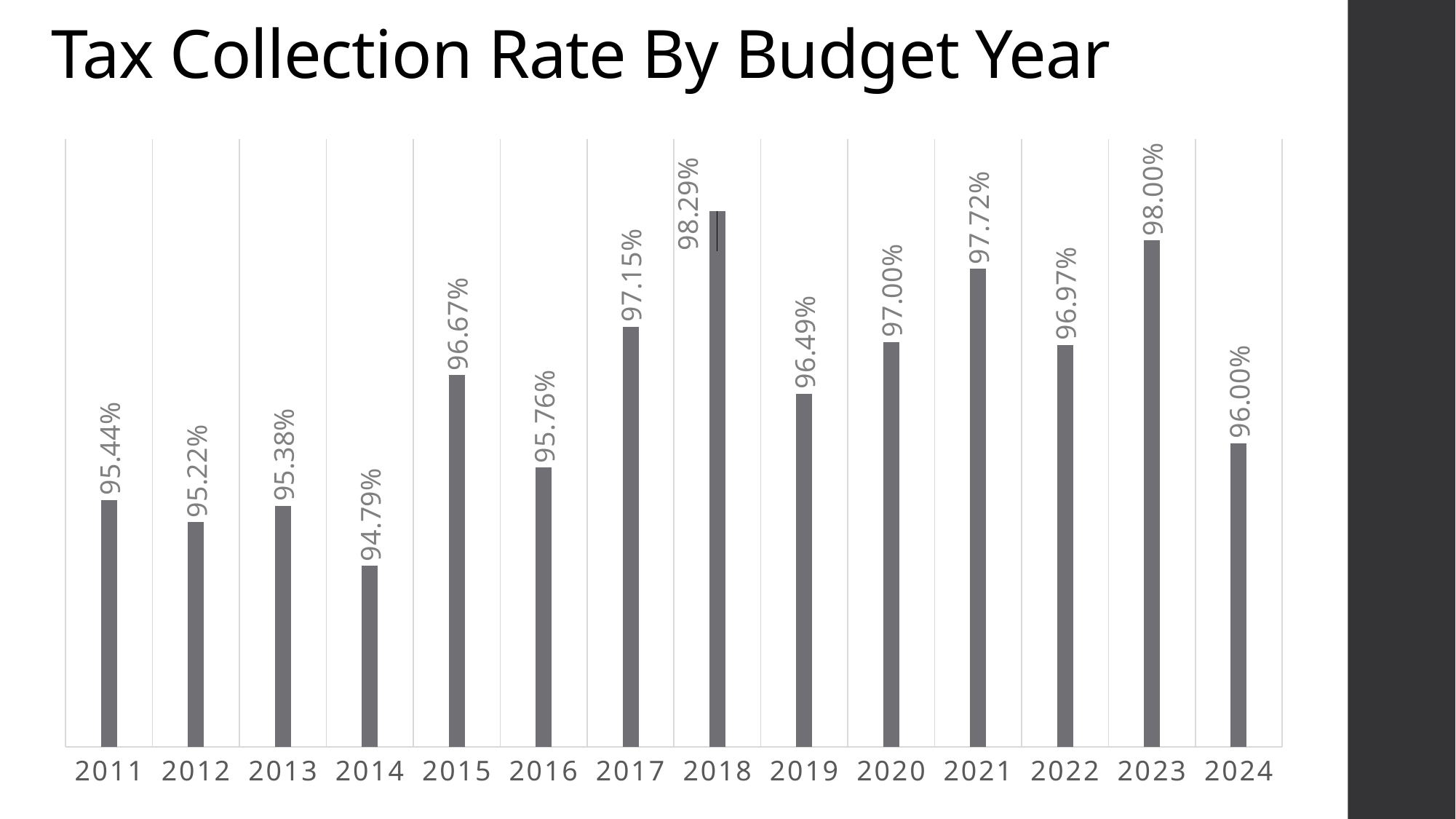
What is the tax collection rate for 2014? 94.79% What is the tax collection rate for 2018? 98.29% What is the difference between the tax collection rates for 2023 and 2024? 2.00% Which budget year has the highest tax collection rate? 2018 How many budget years are shown in the chart? 14 Which year has a higher tax collection rate, 2015 or 2016? 2015 What is the tax collection rate for 2024? 96.00% What kind of chart is shown on the slide? Bar chart Which budget year has the lowest tax collection rate? 2014 What is the title of the chart? Tax Collection Rate By Budget Year What is the tax collection rate for 2021? 97.72% What is the difference between the tax collection rates for 2018 and 2014? 3.50%